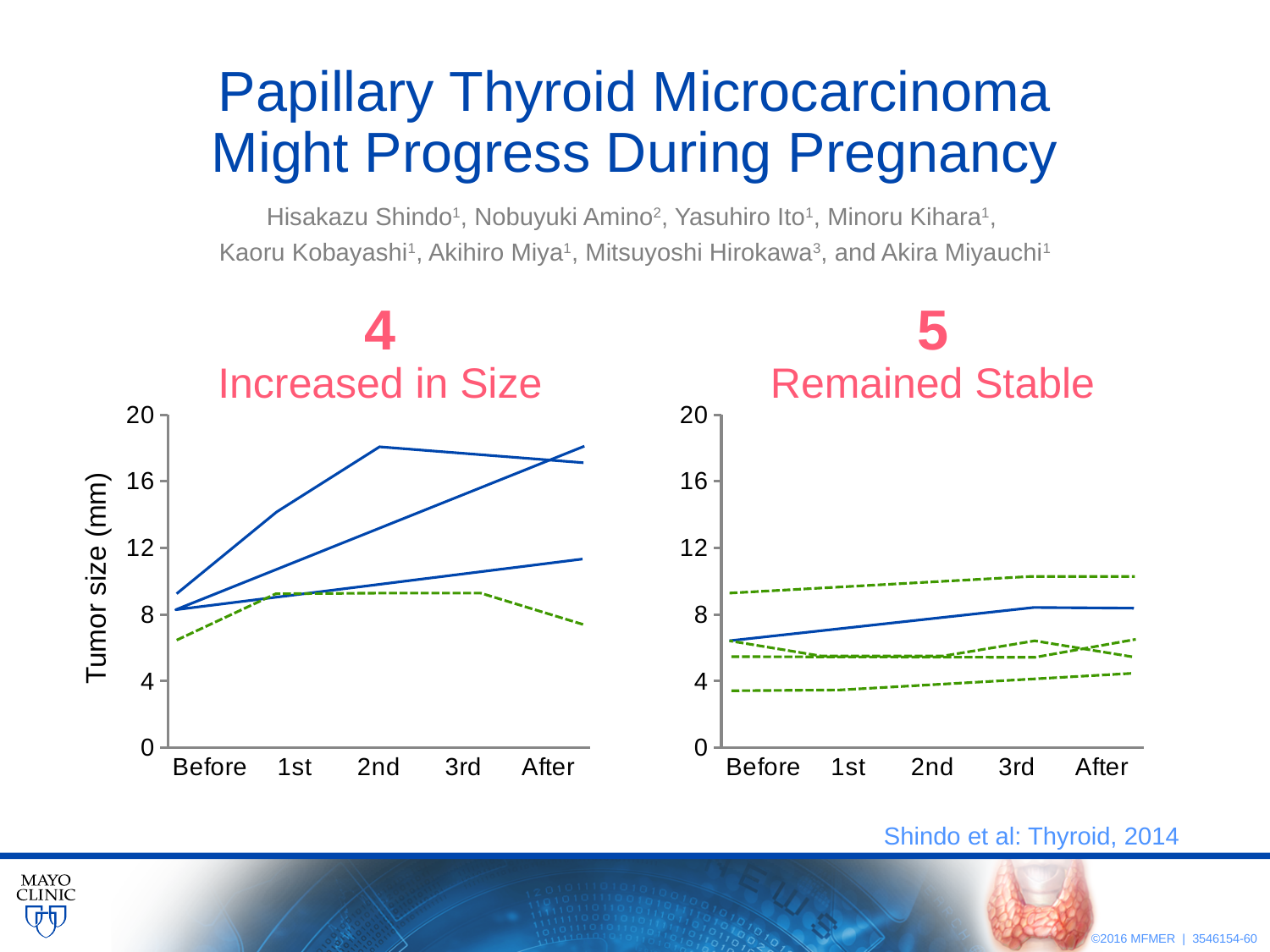
How many lines are plotted in the 'Remained Stable' chart? 5 In the 'Remained Stable' chart, is the value of the lowest line at 'Before' greater or less than 4? less What is the label of the y axis on the left chart? Tumor size (mm) In the 'Remained Stable' chart, is the value of the blue solid line at 'Before' greater or less than 8? less How many time points are shown on the x axis of the 'Remained Stable' chart? 5 In the 'Increased in Size' chart, do the blue solid lines rise or fall from 'Before' to 'After'? rise In the 'Increased in Size' chart, is the value of the green dashed line at 'After' greater or less than 8? less What is the first category on the x axis of the 'Increased in Size' chart? Before How many lines are plotted in the 'Increased in Size' chart? 4 What kind of chart is the 'Increased in Size' chart? line chart